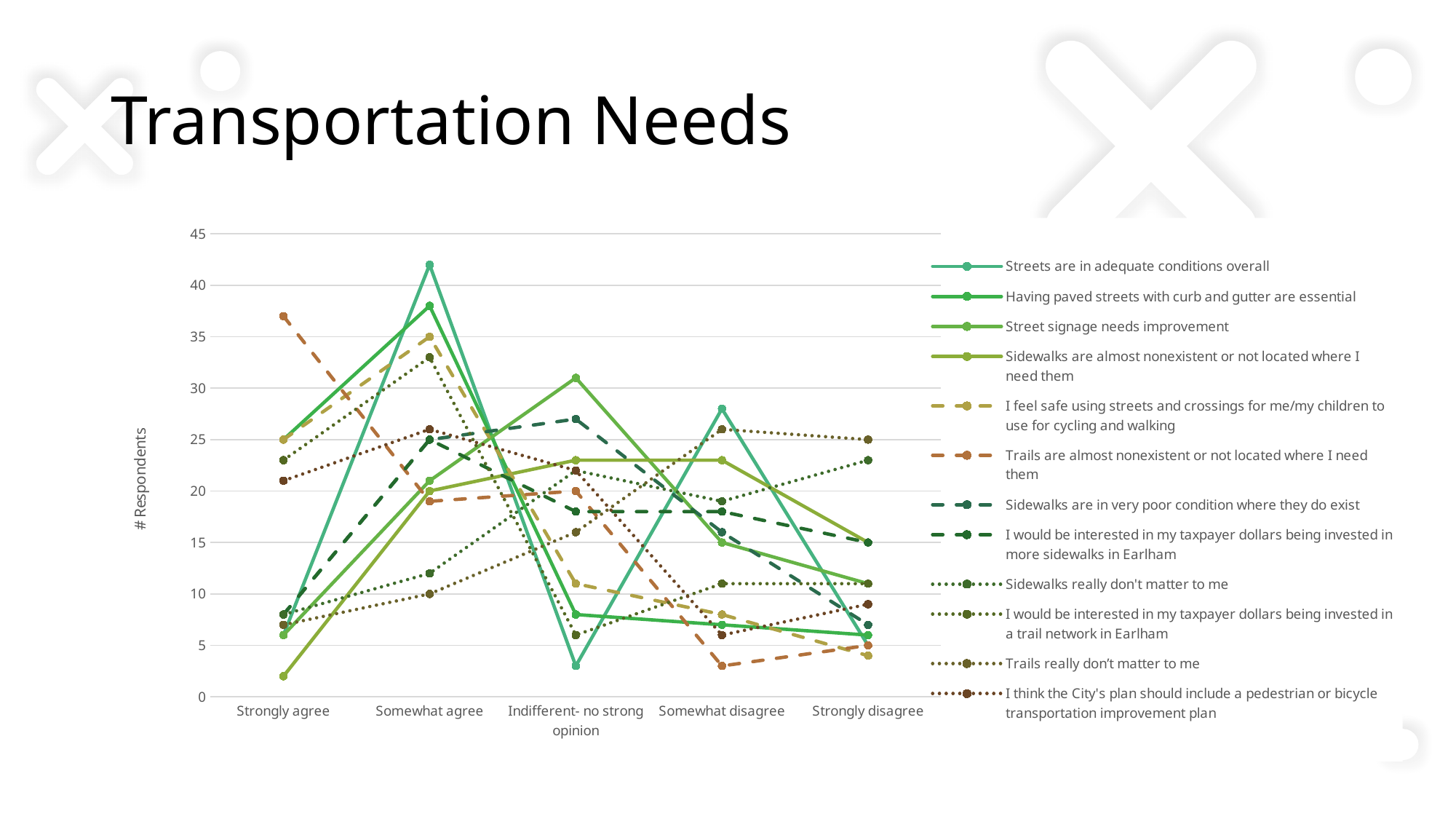
Is the value for 'Street signage needs improvement' at Strongly agree greater or less than 5? greater For 'Streets are in adequate conditions overall', which category has the highest value? Somewhat agree Is the value for 'Streets are in adequate conditions overall' at Somewhat agree greater or less than 40? greater Does the value for 'Trails are almost nonexistent or not located where I need them' rise or fall from Strongly agree to Somewhat agree? fall What is the label of the vertical axis? # Respondents For 'Streets are in adequate conditions overall', which category has the lowest value? Indifferent- no strong opinion How many series does the legend list? 12 For 'Streets are in adequate conditions overall', which is larger: the value at Somewhat agree or at Somewhat disagree? Somewhat agree Is the value for 'Trails are almost nonexistent or not located where I need them' at Strongly agree greater or less than 35? greater Which series reaches the highest value anywhere on the chart? Streets are in adequate conditions overall How many categories are shown along the x axis? 5 What kind of chart is shown on the slide? line chart